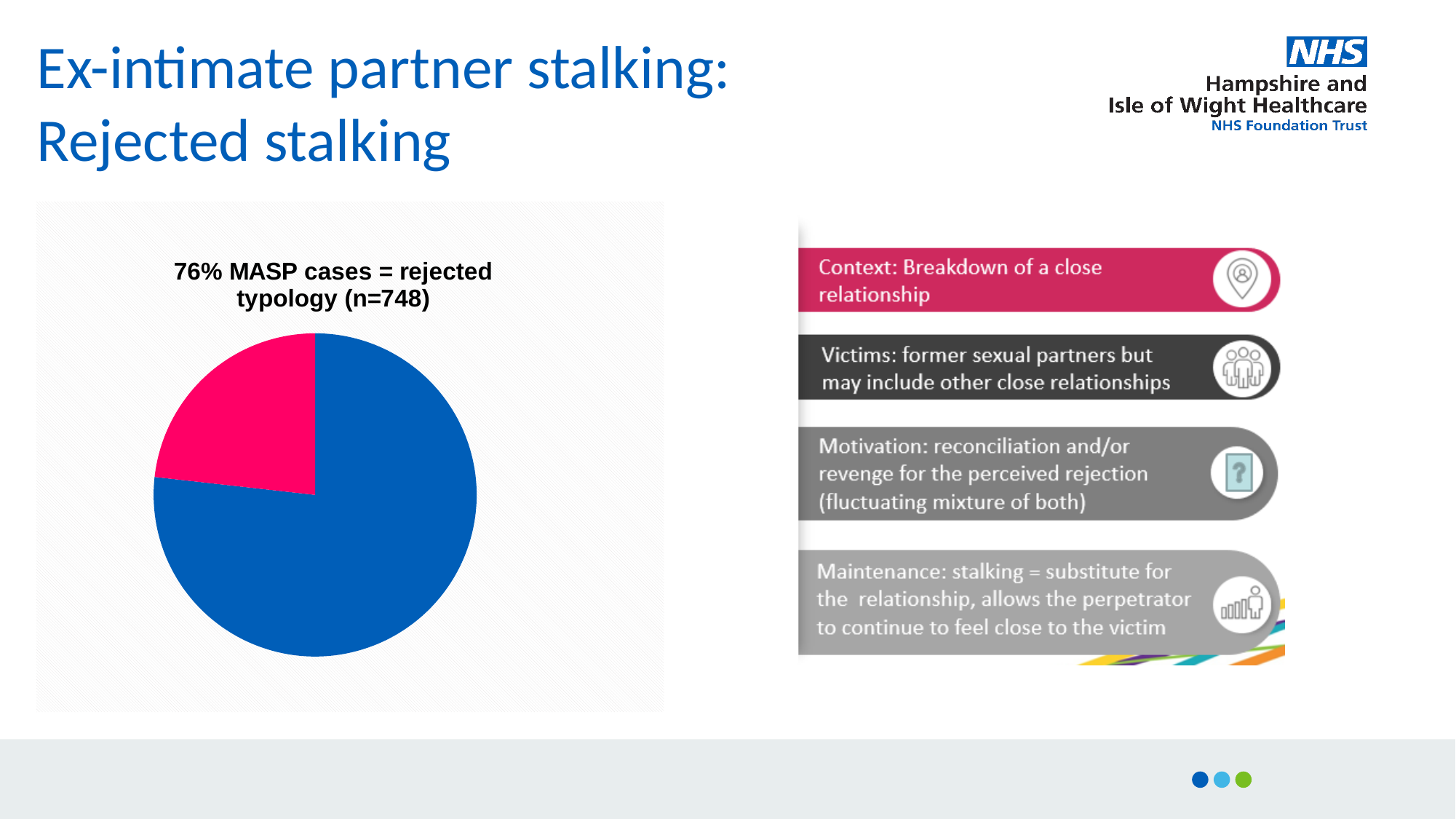
What is the sample size (n) stated in the chart title? 748 Is the pink slice of the pie chart greater or less than half of the pie? less Which slice of the pie chart is larger, the blue one or the pink one? blue What kind of chart is shown on the slide? pie chart How many slices does the pie chart have? 2 What colour is the smaller slice of the pie chart? pink Is the blue slice of the pie chart greater or less than half of the pie? greater What is the title of the pie chart? 76% MASP cases = rejected typology (n=748) According to the chart title, what percentage of MASP cases are of the rejected typology? 76%